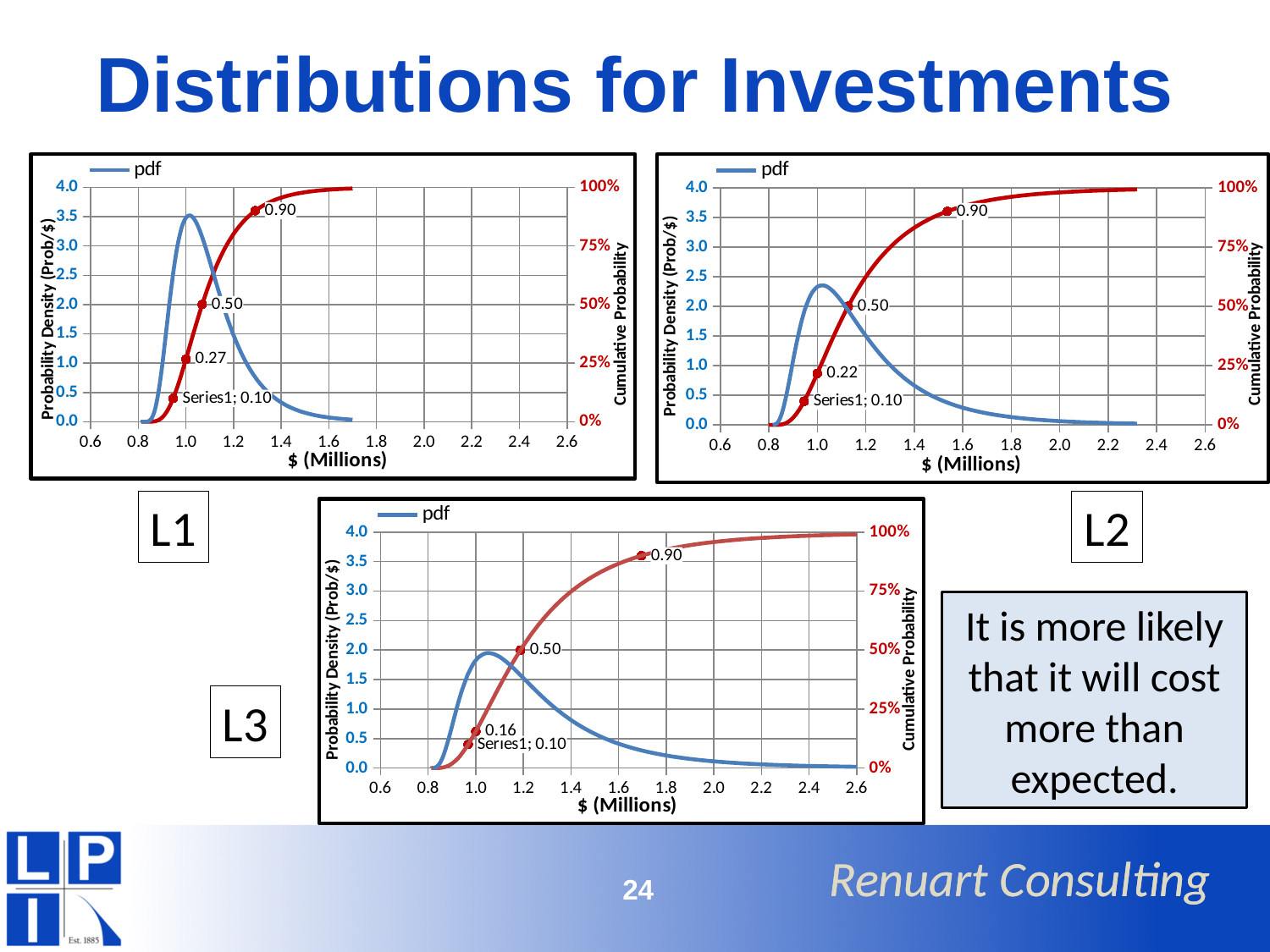
What is the only entry shown in the legend of the top-left chart (L1)? pdf How many labeled points are marked on the cumulative probability curve in the top-left chart (L1)? 4 In the top-left chart (L1), is the peak of the pdf curve greater or less than 3.0? greater In the top-right chart (L2), what is the data label on the cumulative curve between the 0.10 and 0.50 points? 0.22 In the bottom chart (L3), is the peak of the pdf curve greater or less than 2.5? less Which of the three charts has the highest peak on its pdf curve? L1 (top-left) What is the difference between the labeled cumulative value 0.27 in the top-left chart (L1) and the labeled value 0.22 in the top-right chart (L2)? 0.05 What is the x-axis title of the bottom chart (L3)? $ (Millions) Which is larger: the labeled cumulative value between 0.10 and 0.50 in the top-left chart (L1) or the corresponding value in the top-right chart (L2)? L1 (0.27) What kind of chart is the top-left chart (L1)? line chart In the top-left chart (L1), what is the data label on the cumulative curve between the 0.10 and 0.50 points? 0.27 In the bottom chart (L3), what is the data label on the cumulative curve between the 0.10 and 0.50 points? 0.16